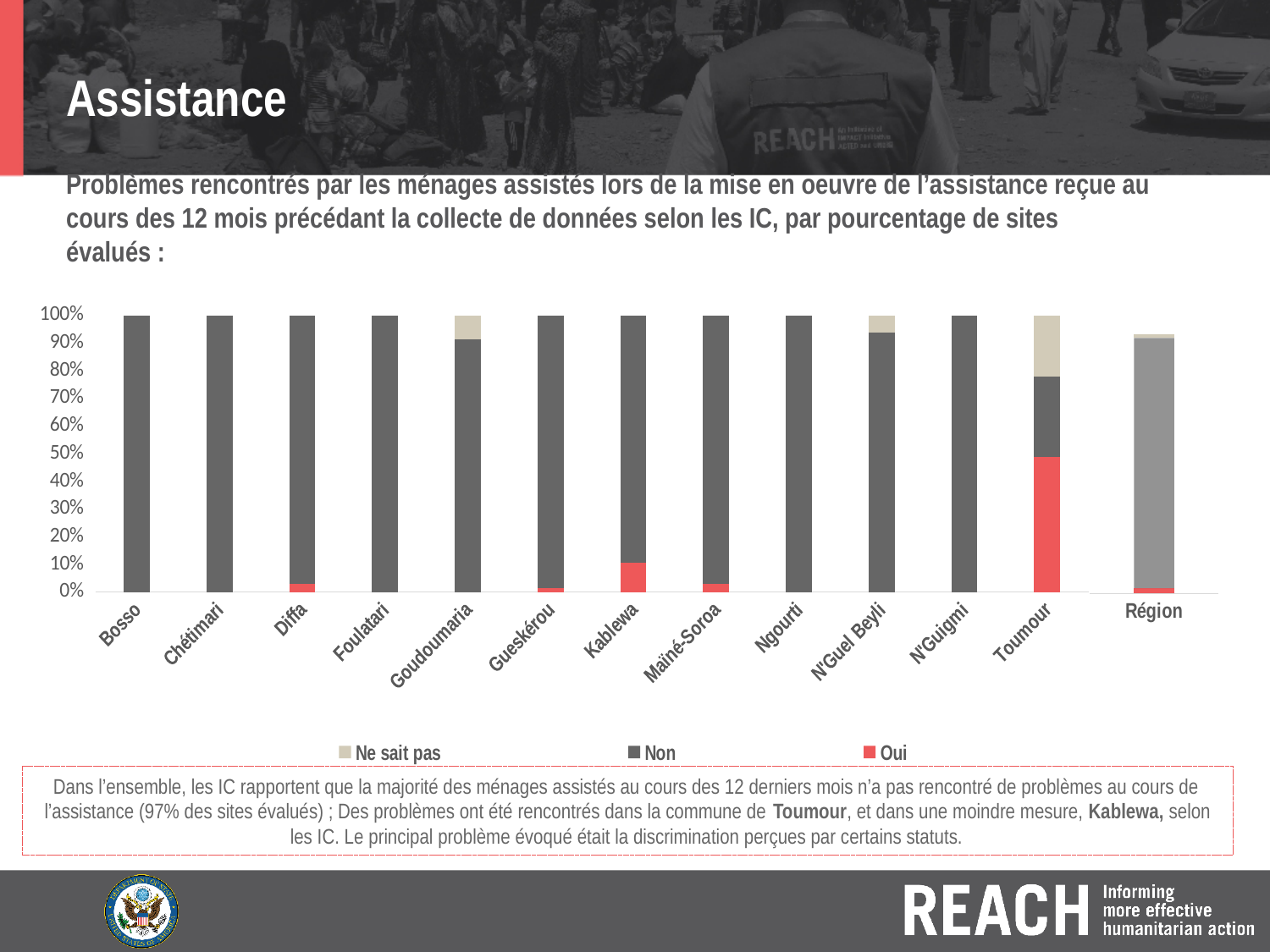
Which category has the highest value for the 'Oui' series? Toumour Is the 'Oui' value for Toumour greater or less than 40%? greater What are the three legend entries of the chart? Ne sait pas, Non, Oui What kind of chart is shown on the slide? Stacked bar chart How many categories are shown along the x axis? 13 Is the 'Non' value for Goudoumaria greater or less than 80%? greater Is the 'Ne sait pas' value for Toumour greater or less than 10%? greater What is the 'Non' value for Bosso? 100% How many series does the legend list? 3 Which has a larger 'Oui' value, Toumour or Kablewa? Toumour Which colour represents the 'Oui' series in the legend? Red